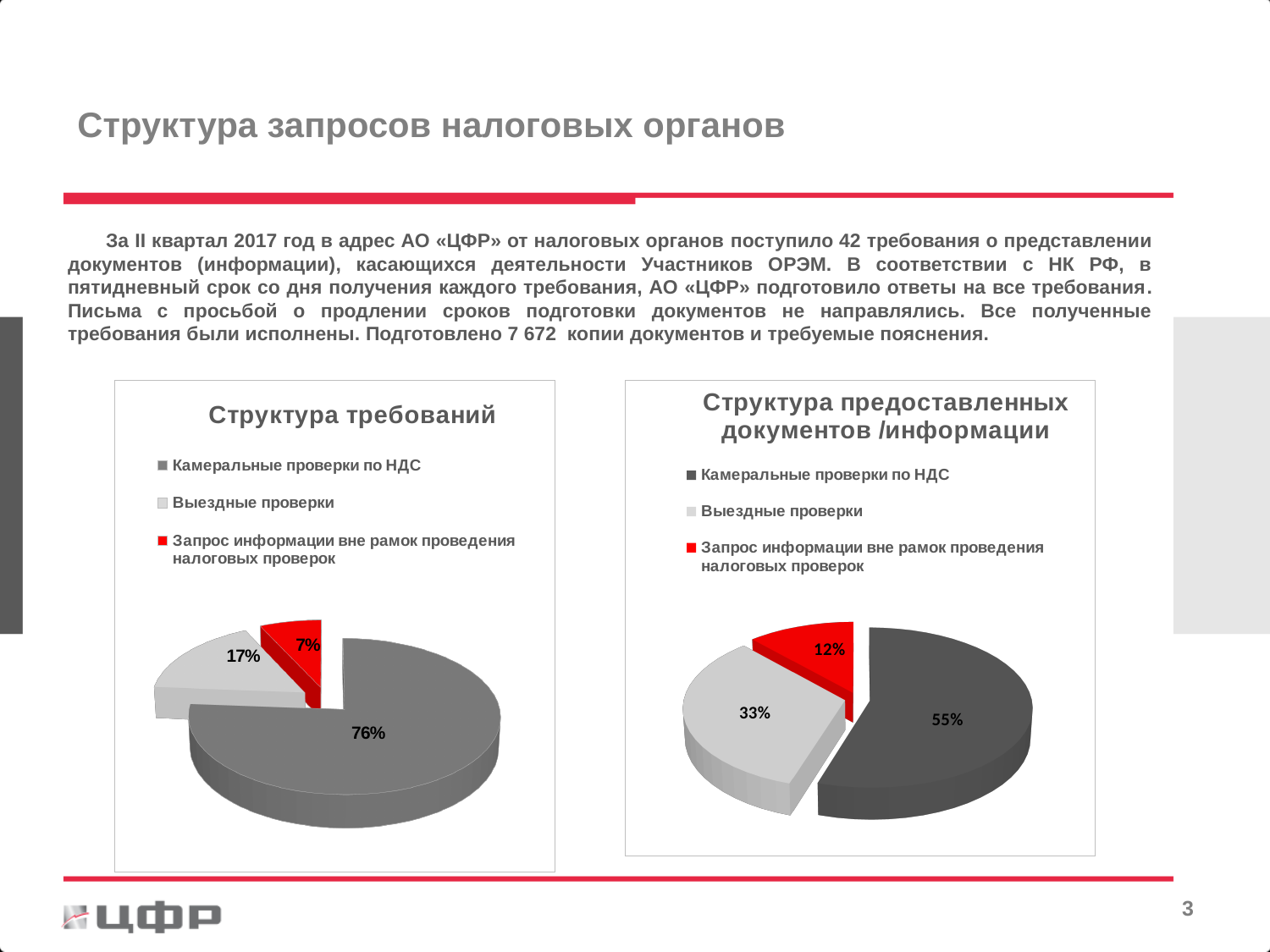
In the chart titled "Структура требований", what share is shown for Камеральные проверки по НДС? 76% In the chart titled "Структура предоставленных документов /информации", which is larger: Выездные проверки or Запрос информации вне рамок проведения налоговых проверок? Выездные проверки What type of chart is the chart titled "Структура требований"? Pie chart How many series does the legend of the chart titled "Структура предоставленных документов /информации" list? 3 In the chart titled "Структура требований", what is the difference in percentage points between Камеральные проверки по НДС and Выездные проверки? 59 In the chart titled "Структура требований", what share is shown for Выездные проверки? 17% In the chart titled "Структура предоставленных документов /информации", which category has the smallest slice? Запрос информации вне рамок проведения налоговых проверок In the chart titled "Структура требований", which category has the largest slice? Камеральные проверки по НДС In the chart titled "Структура предоставленных документов /информации", what share is shown for Выездные проверки? 33% In the chart titled "Структура требований", what share is shown for Запрос информации вне рамок проведения налоговых проверок? 7% In the chart titled "Структура предоставленных документов /информации", what share is shown for Камеральные проверки по НДС? 55% In the chart titled "Структура предоставленных документов /информации", what share is shown for Запрос информации вне рамок проведения налоговых проверок? 12%